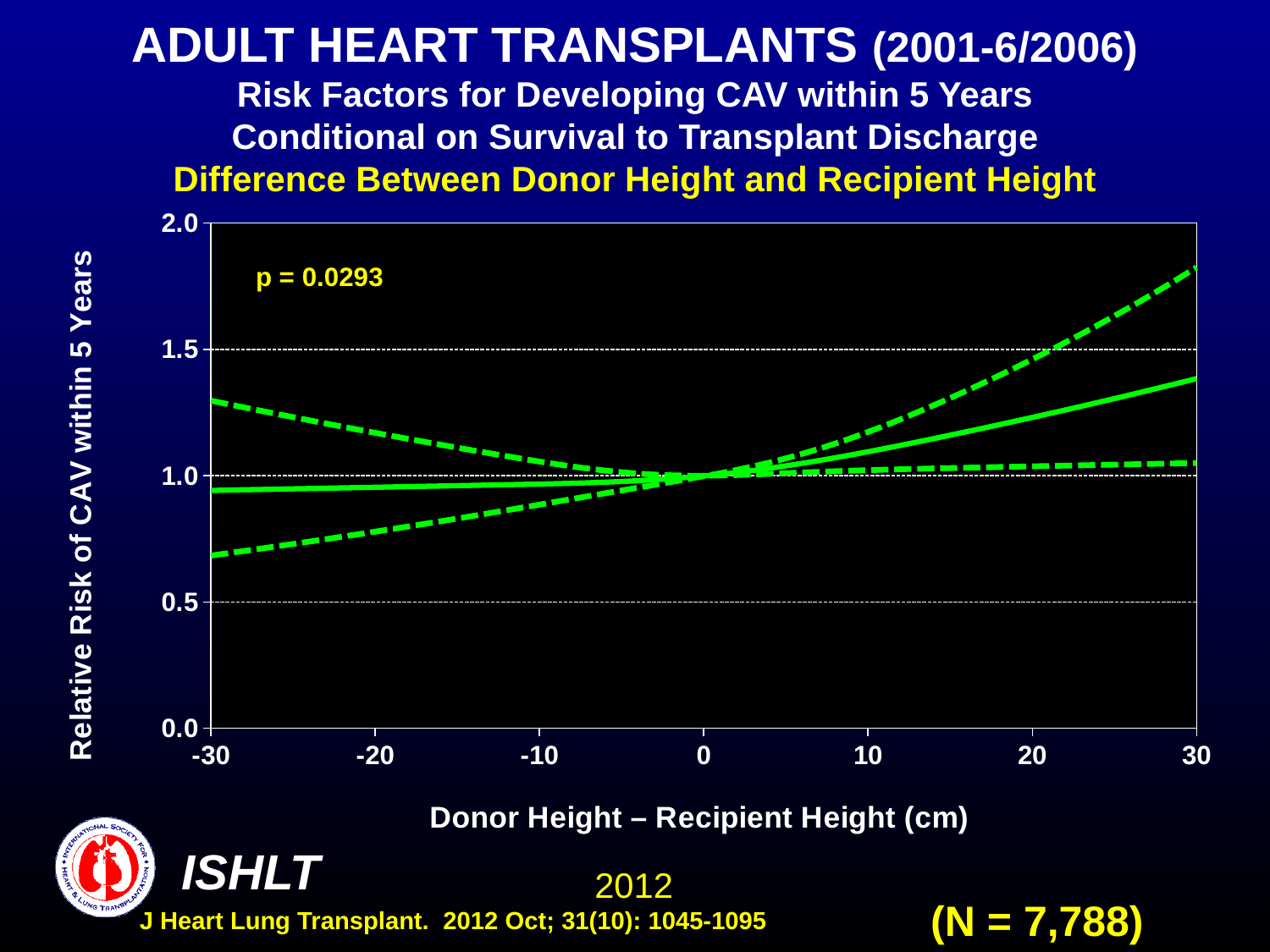
Is the value of the upper dashed line at a height difference of 30 cm greater or less than 1.5? greater What is the sample size (N) shown on the slide? N = 7,788 How many lines are plotted on the chart? 3 What is the relative risk on the solid line at a height difference of 0 cm? 1.0 Is the value of the lower dashed line at a height difference of -30 cm greater or less than 0.5? greater What is the label of the x axis? Donor Height – Recipient Height (cm) What is the p-value printed on the chart? p = 0.0293 Is the value of the solid line at a height difference of 30 cm greater or less than 1.5? less Does the solid line rise or fall as the donor-recipient height difference increases from -30 to 30 cm? rise What kind of chart is shown on the slide? line chart